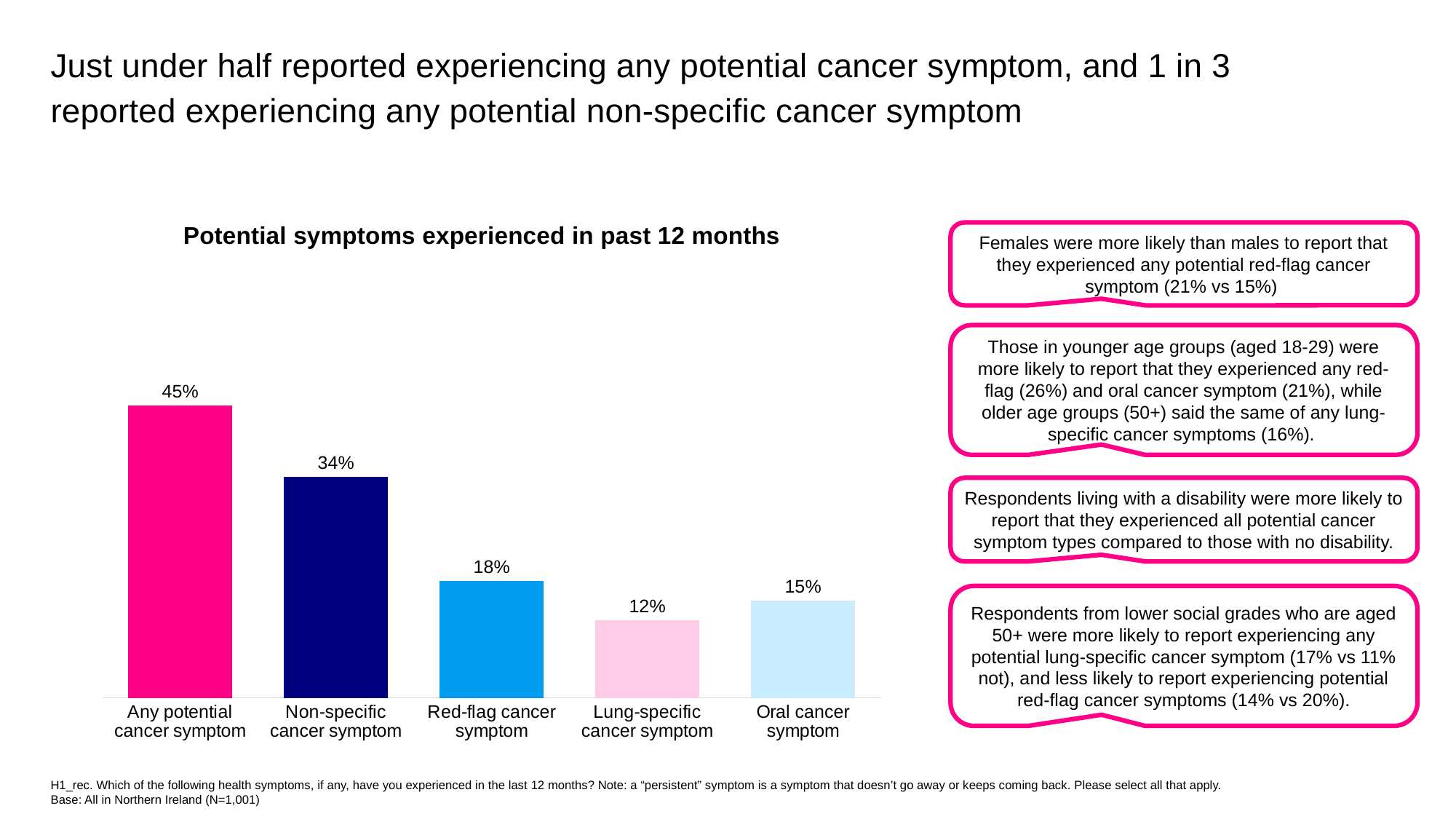
What percentage reported experiencing any potential cancer symptom? 45% Which category has the lowest value? Lung-specific cancer symptom What type of chart is shown? Bar chart What percentage reported a Lung-specific cancer symptom? 12% What is the value for Oral cancer symptom? 15% What is the title of the chart? Potential symptoms experienced in past 12 months Which category has the highest value? Any potential cancer symptom What is the value for Non-specific cancer symptom? 34% Which is larger, Red-flag cancer symptom or Lung-specific cancer symptom? Red-flag cancer symptom What is the difference between Red-flag cancer symptom and Oral cancer symptom? 3% What is the difference between Any potential cancer symptom and Non-specific cancer symptom? 11% How many categories are shown in the chart? 5